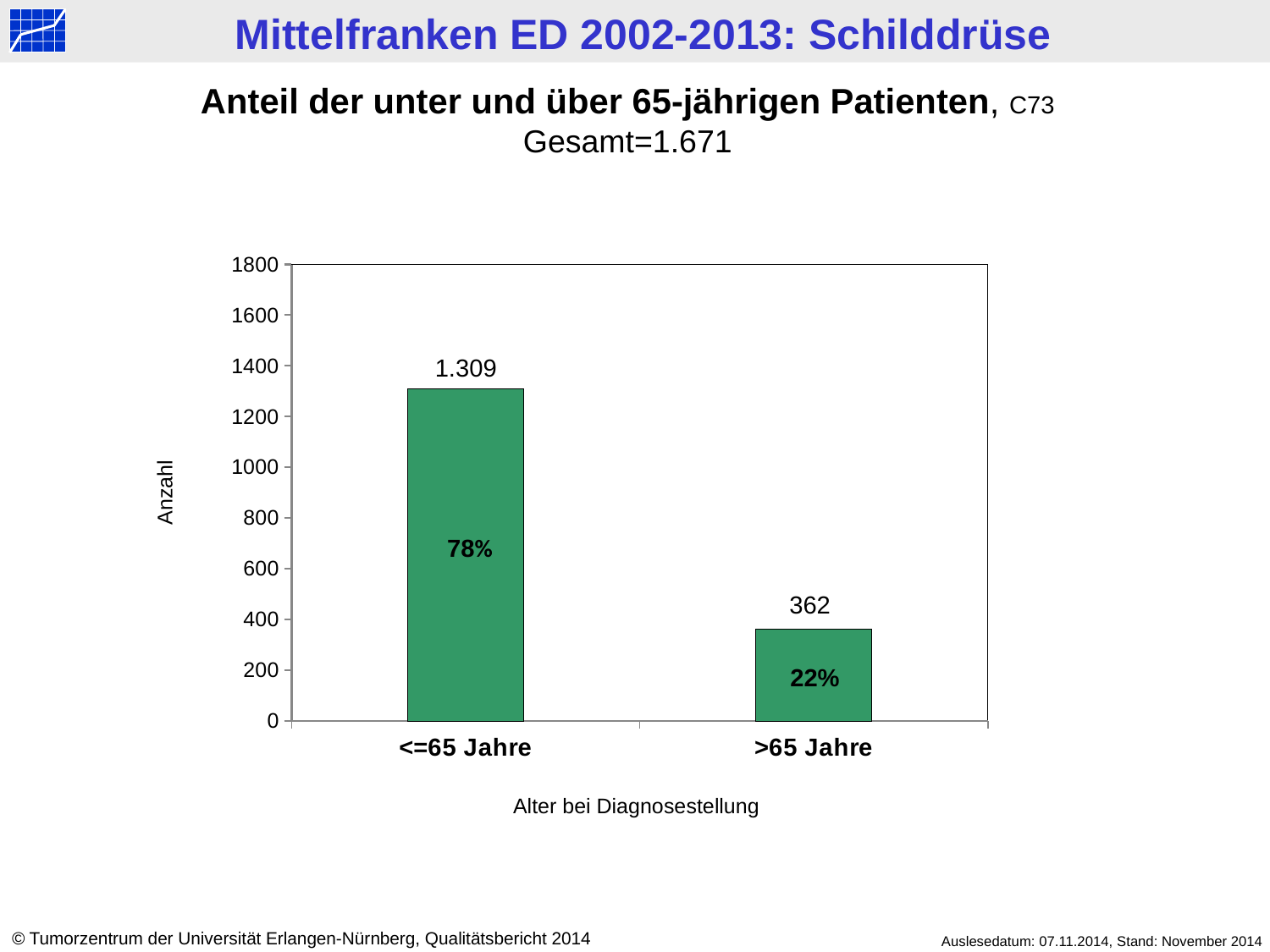
What percentage is shown on the <=65 Jahre bar? 78% Is the value for >65 Jahre greater or less than 400? less Which category has the highest value? <=65 Jahre Which category has the lowest value? >65 Jahre What percentage is shown on the >65 Jahre bar? 22% Which is larger, the value for <=65 Jahre or for >65 Jahre? <=65 Jahre What is the value for the >65 Jahre category? 362 What is the value for the <=65 Jahre category? 1.309 How many categories are shown on the x axis? 2 What kind of chart is shown on the slide? bar chart What is the difference between the values for <=65 Jahre and >65 Jahre? 947 What is the label of the y axis? Anzahl